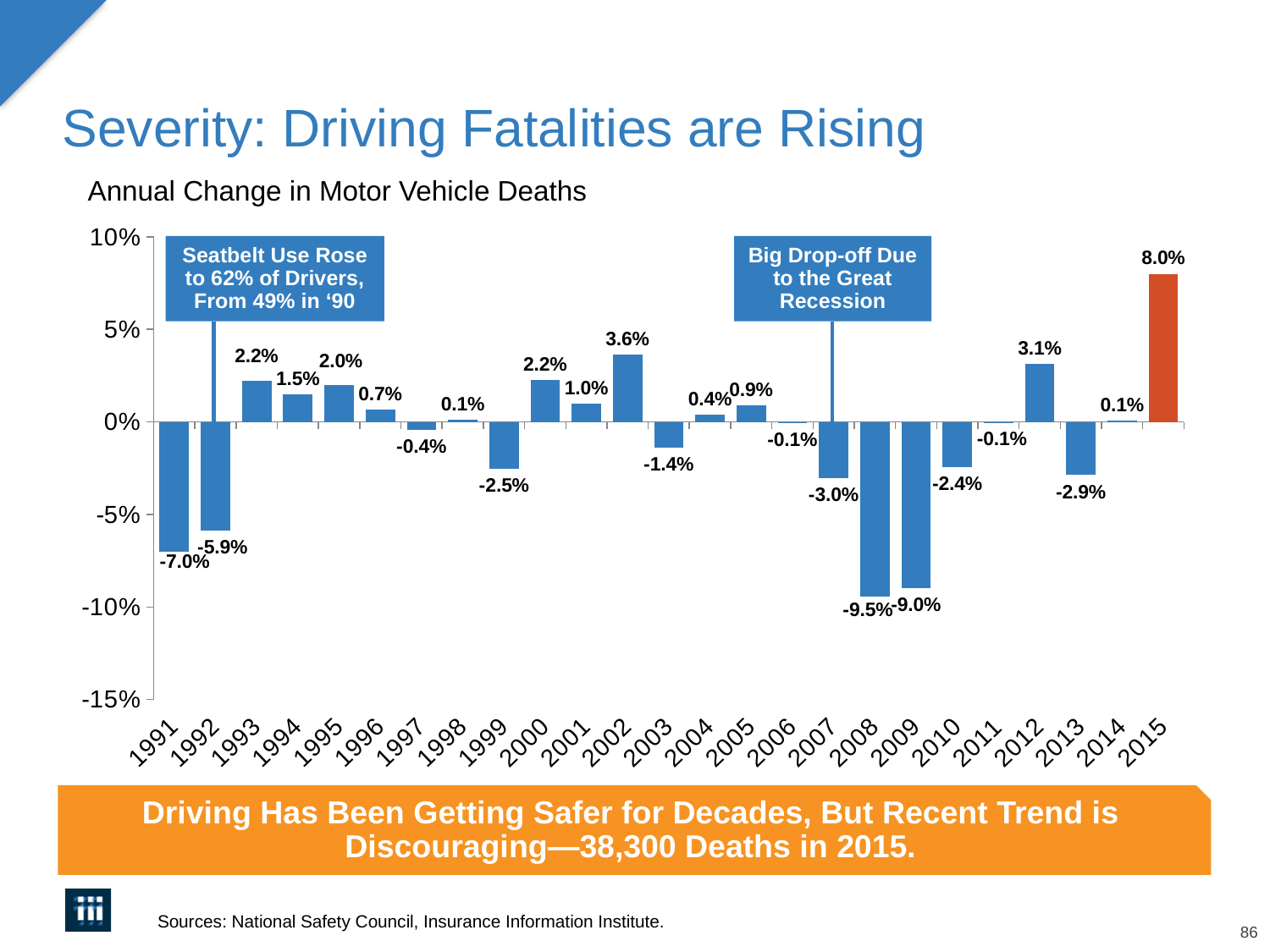
According to the callout on the chart, what caused the big drop-off in 2008 and 2009? The Great Recession What is the annual change in motor vehicle deaths for 2008? -9.5% What is the annual change in motor vehicle deaths for 2015? 8.0% How many years are shown on the x axis of the chart? 25 What is the annual change in motor vehicle deaths for 2002? 3.6% Which year has a larger annual change in motor vehicle deaths, 2009 or 2010? 2010 Which year has the lowest annual change in motor vehicle deaths? 2008 What is the annual change in motor vehicle deaths for 1991? -7.0% What kind of chart is used to show the annual change in motor vehicle deaths? Bar chart What is the difference between the annual change in 2015 and the annual change in 2012? 4.9 percentage points Which year has the highest annual change in motor vehicle deaths? 2015 What is the annual change in motor vehicle deaths for 2013? -2.9%